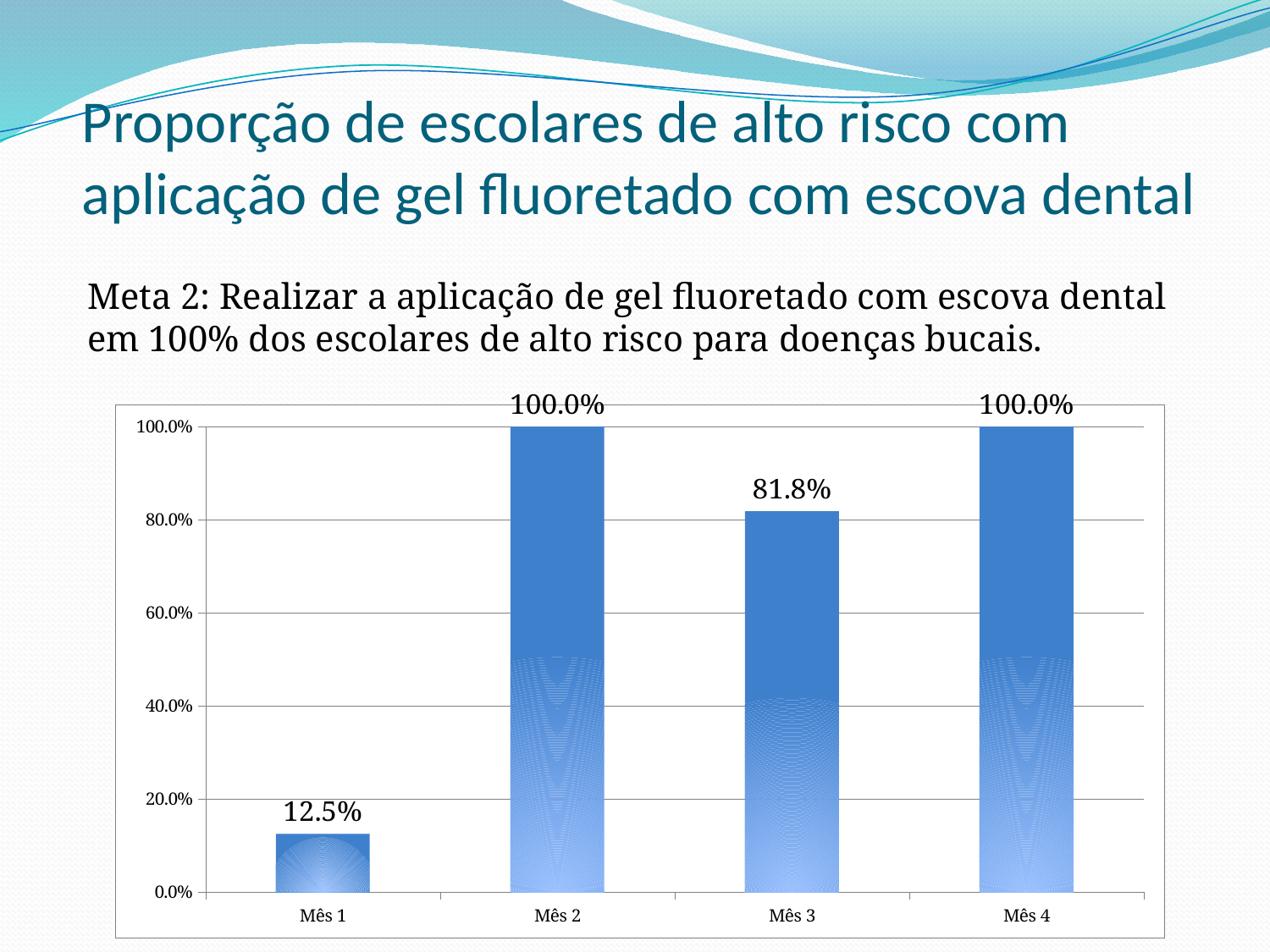
What is the difference between the values for Mês 3 and Mês 1? 69.3% Is the value for Mês 3 greater or less than 60.0%? greater Which is larger, the value for Mês 1 or the value for Mês 3? Mês 3 What kind of chart is shown on the slide? bar chart What is the value for Mês 1? 12.5% Is the value for Mês 1 greater or less than 20.0%? less What is the difference between the values for Mês 2 and Mês 3? 18.2% What is the value for Mês 3? 81.8% What is the value for Mês 2? 100.0% How many months are shown on the x axis? 4 Which month has the lowest value? Mês 1 How many months reach the 100.0% target? 2